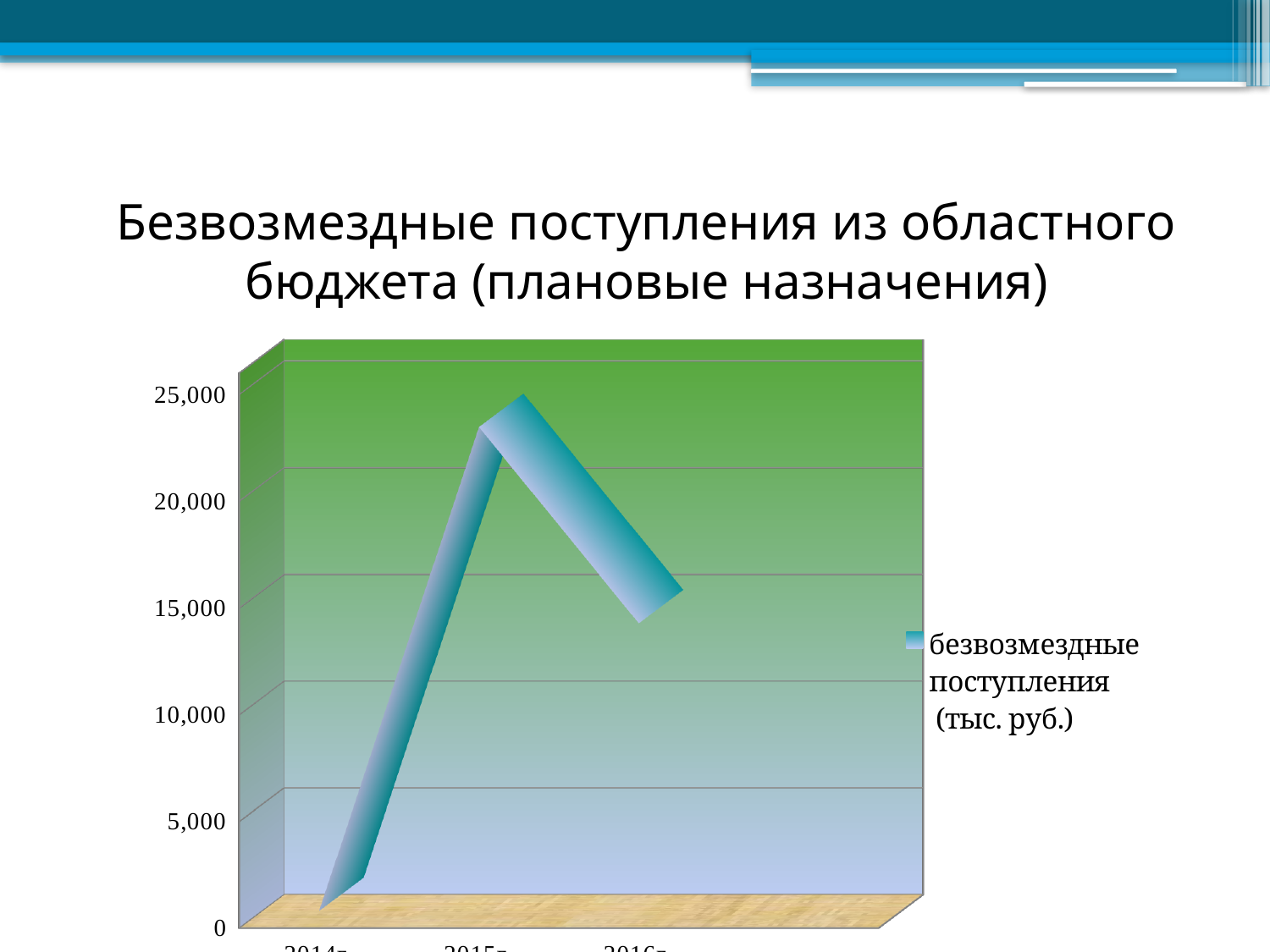
Is the value for 2016г greater or less than 10,000? greater Is the value for 2015г greater or less than 20,000? greater Which year has the larger value, 2014г or 2016г? 2016г Which year has the highest value for безвозмездные поступления? 2015г How many series does the chart legend list? 1 Which year has the larger value, 2015г or 2016г? 2015г What series name does the chart legend show? безвозмездные поступления (тыс. руб.) Is the value for 2014г greater or less than 5,000? less Which year has the lowest value for безвозмездные поступления? 2014г How many years are plotted along the x axis of the chart? 3 How does the value change from 2014г to 2015г and then to 2016г? rises, then falls What kind of chart is shown on the slide? line chart